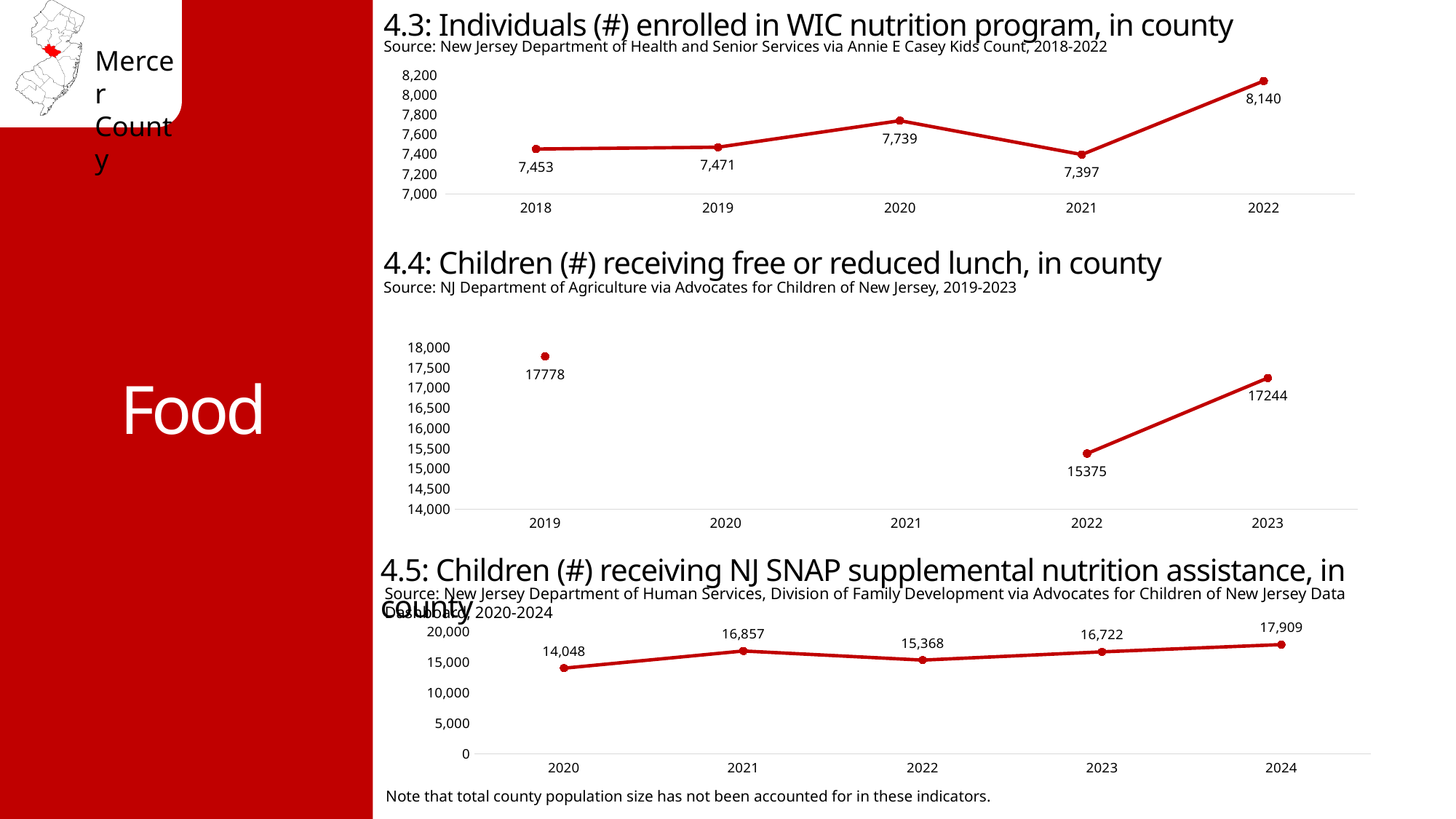
In the chart '4.4: Children (#) receiving free or reduced lunch, in county', what is the value for 2022? 15375 In the chart '4.5: Children (#) receiving NJ SNAP supplemental nutrition assistance, in county', what is the difference between the 2024 and 2020 values? 3,861 In the chart '4.3: Individuals (#) enrolled in WIC nutrition program, in county', what is the value for 2020? 7,739 In the chart '4.5: Children (#) receiving NJ SNAP supplemental nutrition assistance, in county', is the value for 2022 greater or less than 10,000? greater In the chart '4.3: Individuals (#) enrolled in WIC nutrition program, in county', which year has the lowest value? 2021 In the chart '4.3: Individuals (#) enrolled in WIC nutrition program, in county', which year has the highest value? 2022 In the chart '4.5: Children (#) receiving NJ SNAP supplemental nutrition assistance, in county', what is the value for 2021? 16,857 In the chart '4.3: Individuals (#) enrolled in WIC nutrition program, in county', what is the difference between the 2022 and 2021 values? 743 In the chart '4.4: Children (#) receiving free or reduced lunch, in county', which is larger, the value for 2019 or the value for 2023? 2019 In the chart '4.4: Children (#) receiving free or reduced lunch, in county', how many data points are plotted? 3 In the chart '4.5: Children (#) receiving NJ SNAP supplemental nutrition assistance, in county', which year has the lowest value? 2020 What kind of chart is '4.3: Individuals (#) enrolled in WIC nutrition program, in county'? line chart